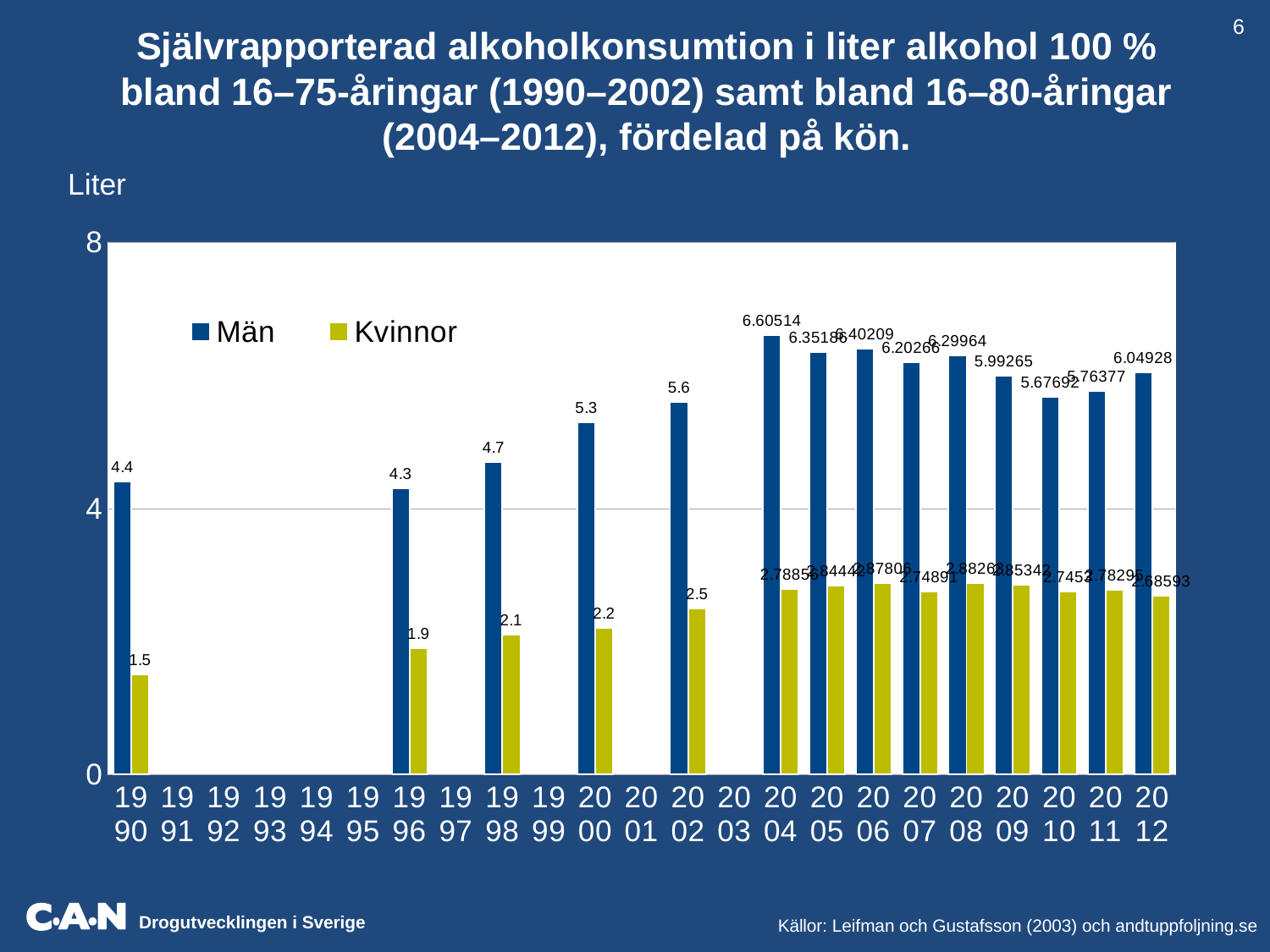
What is the value for Kvinnor in 2002? 2.5 What is the value for Män in 1990? 4.4 What is the value for Män in 2004? 6.60514 Which year has the larger value for Män, 1998 or 2000? 2000 Do the values for Kvinnor rise or fall from 1990 to 2002? rise In which year is the value for Kvinnor lowest? 1990 What is the difference between the Män and Kvinnor values in 2002? 3.1 How many series does the legend list? 2 What is the value for Män in 2009? 5.99265 Is the value for Män in 2012 greater or less than 4? greater In which year is the value for Män highest? 2004 What kind of chart is shown on the slide? bar chart